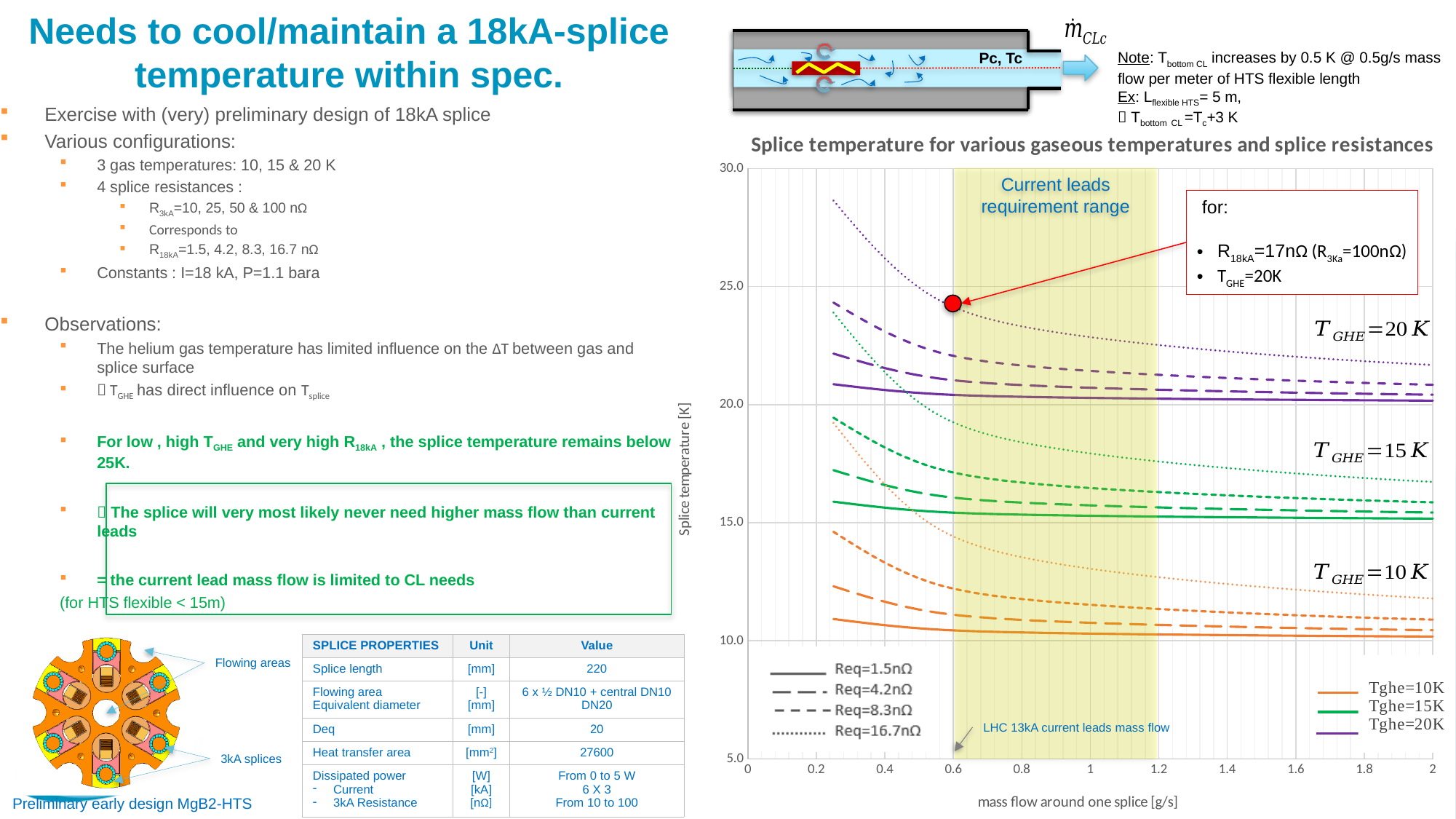
Is the splice temperature for Tghe=10K with Req=16.7nΩ at a mass flow of 2 g/s greater or less than 10 K? greater How many Req (splice resistance) values does the chart legend list? 4 What is the title of the chart? Splice temperature for various gaseous temperatures and splice resistances Which gas temperature series has the lowest splice temperature curves on the chart? Tghe=10K As mass flow increases along the x axis, do the splice temperature curves rise or fall? fall Is the splice temperature for Tghe=20K with Req=1.5nΩ at a mass flow of 2 g/s greater or less than 25 K? less What is the label of the x axis of the chart? mass flow around one splice [g/s] How many Tghe (gas temperature) values does the chart legend list? 3 At a mass flow of 1 g/s with Req=16.7nΩ, which gas temperature gives the higher splice temperature: Tghe=20K or Tghe=15K? Tghe=20K What kind of chart is shown on the slide? line chart Is the splice temperature for Tghe=20K with Req=16.7nΩ at a mass flow of 0.6 g/s greater or less than 25 K? less